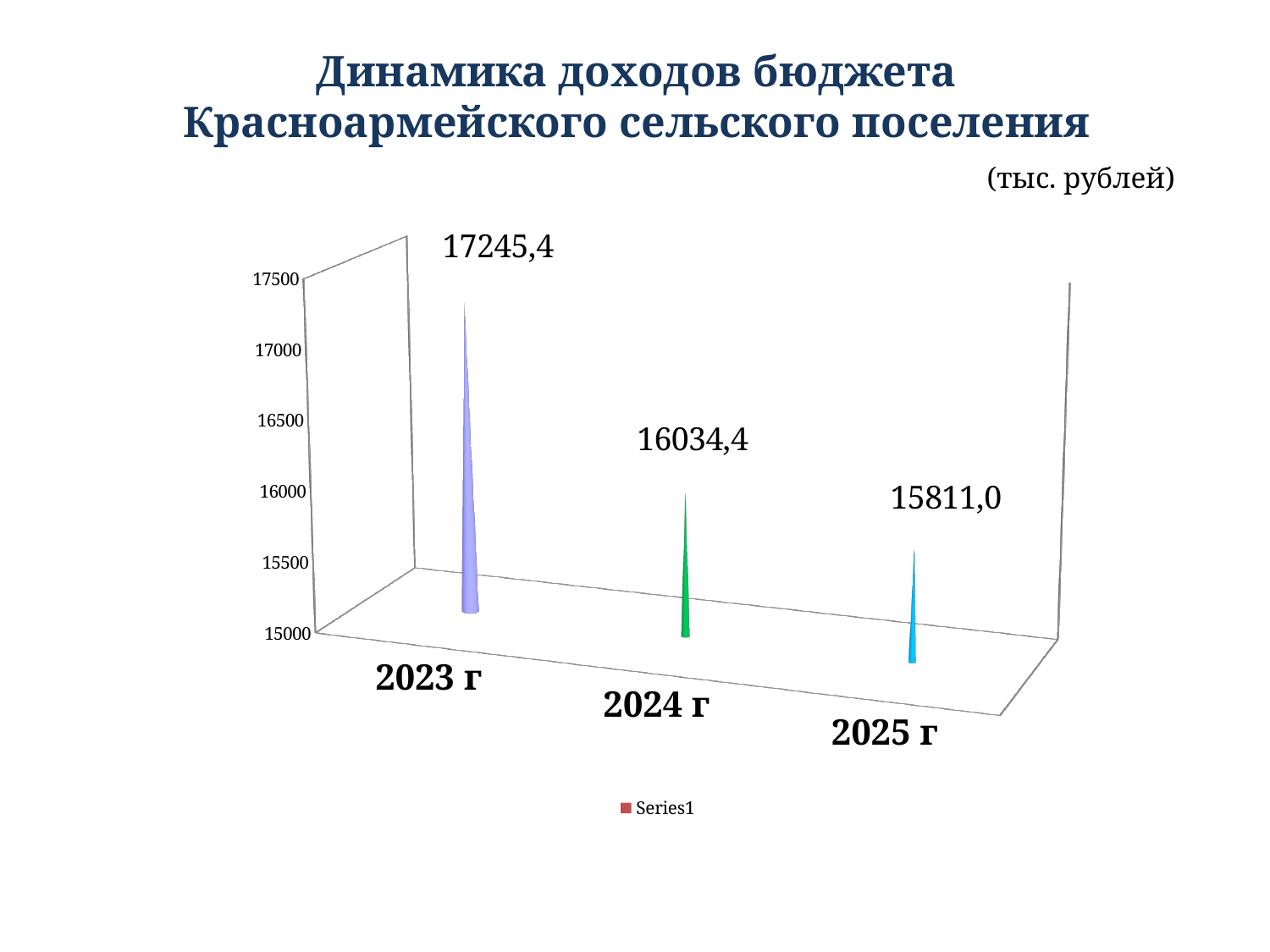
What is the budget revenue value shown for 2023 г? 17245,4 What is the budget revenue value shown for 2024 г? 16034,4 Which year has the highest budget revenue value? 2023 г How many years are plotted on the chart? 3 What is the difference between the values for 2024 г and 2025 г? 223,4 Is the value for 2024 г greater or less than 16500? less Which is larger, the value for 2023 г or the value for 2025 г? 2023 г What unit of measurement is indicated for the chart values? тыс. рублей Which year has the lowest budget revenue value? 2025 г What is the budget revenue value shown for 2025 г? 15811,0 Do the values rise or fall from 2023 г to 2025 г? fall What is the difference between the values for 2023 г and 2024 г? 1211,0